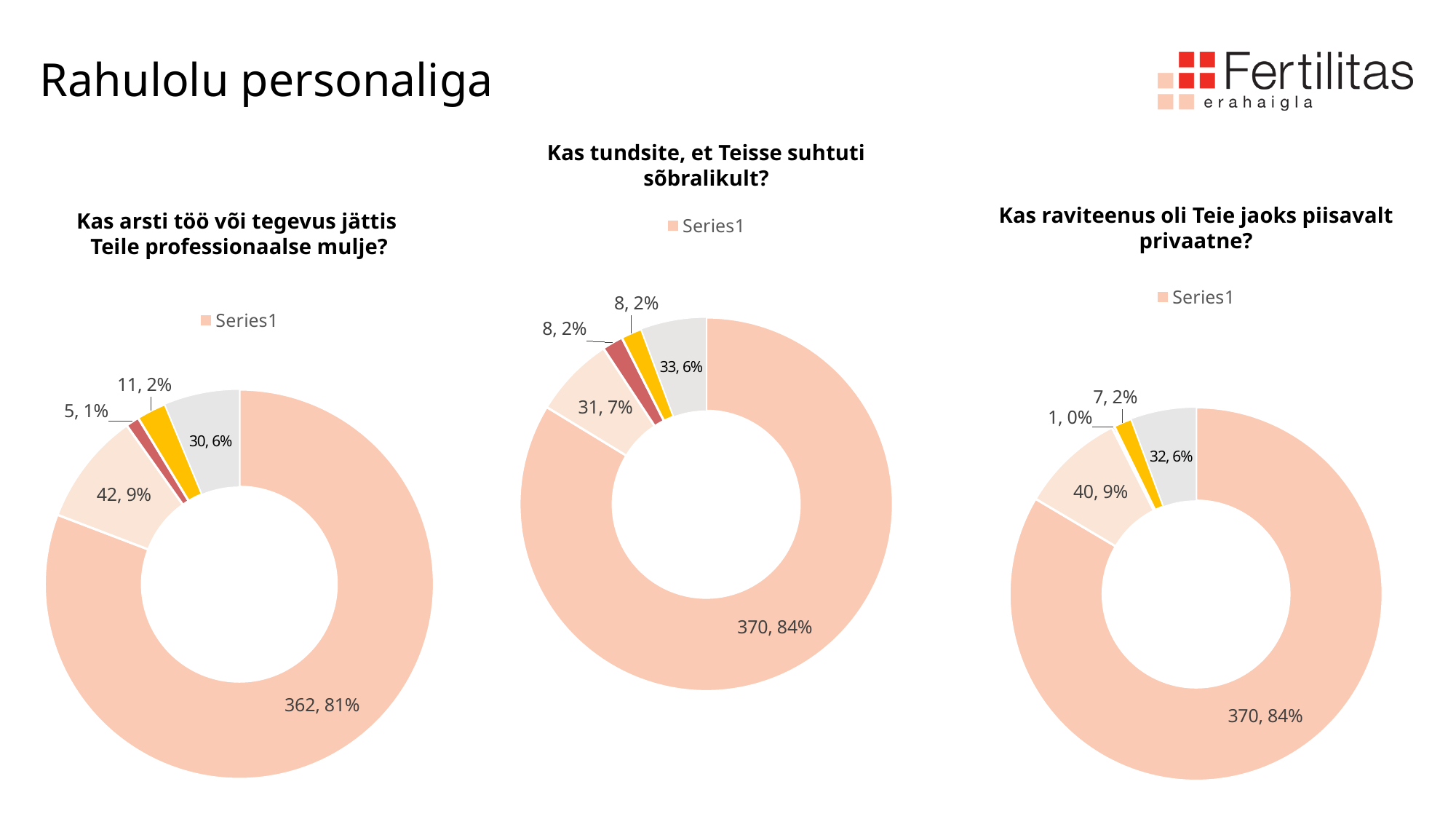
How many slices does the chart "Kas arsti töö või tegevus jättis Teile professionaalse mulje?" have? 5 How many series does the legend of the chart "Kas tundsite, et Teisse suhtuti sõbralikult?" list? 1 In the chart "Kas arsti töö või tegevus jättis Teile professionaalse mulje?", what is the data label on the largest slice? 362, 81% In the chart "Kas arsti töö või tegevus jättis Teile professionaalse mulje?", what is the difference between the largest slice (362) and the slice labelled 42? 320 What is the legend entry shown for the chart "Kas raviteenus oli Teie jaoks piisavalt privaatne?"? Series1 In the chart "Kas tundsite, et Teisse suhtuti sõbralikult?", what is the value of the largest slice? 370 In the chart "Kas arsti töö või tegevus jättis Teile professionaalse mulje?", what share of the total does the largest slice represent? 81% In the chart "Kas tundsite, et Teisse suhtuti sõbralikult?", what is the data label on the yellow slice? 8, 2% In the chart "Kas raviteenus oli Teie jaoks piisavalt privaatne?", what is the value of the smallest slice? 1 In the chart "Kas raviteenus oli Teie jaoks piisavalt privaatne?", which is larger: the slice labelled 40 or the slice labelled 32? The slice labelled 40 What kind of chart is used for "Kas arsti töö või tegevus jättis Teile professionaalse mulje?"? Doughnut (pie) chart In the chart "Kas raviteenus oli Teie jaoks piisavalt privaatne?", what is the data label on the grey slice? 32, 6%